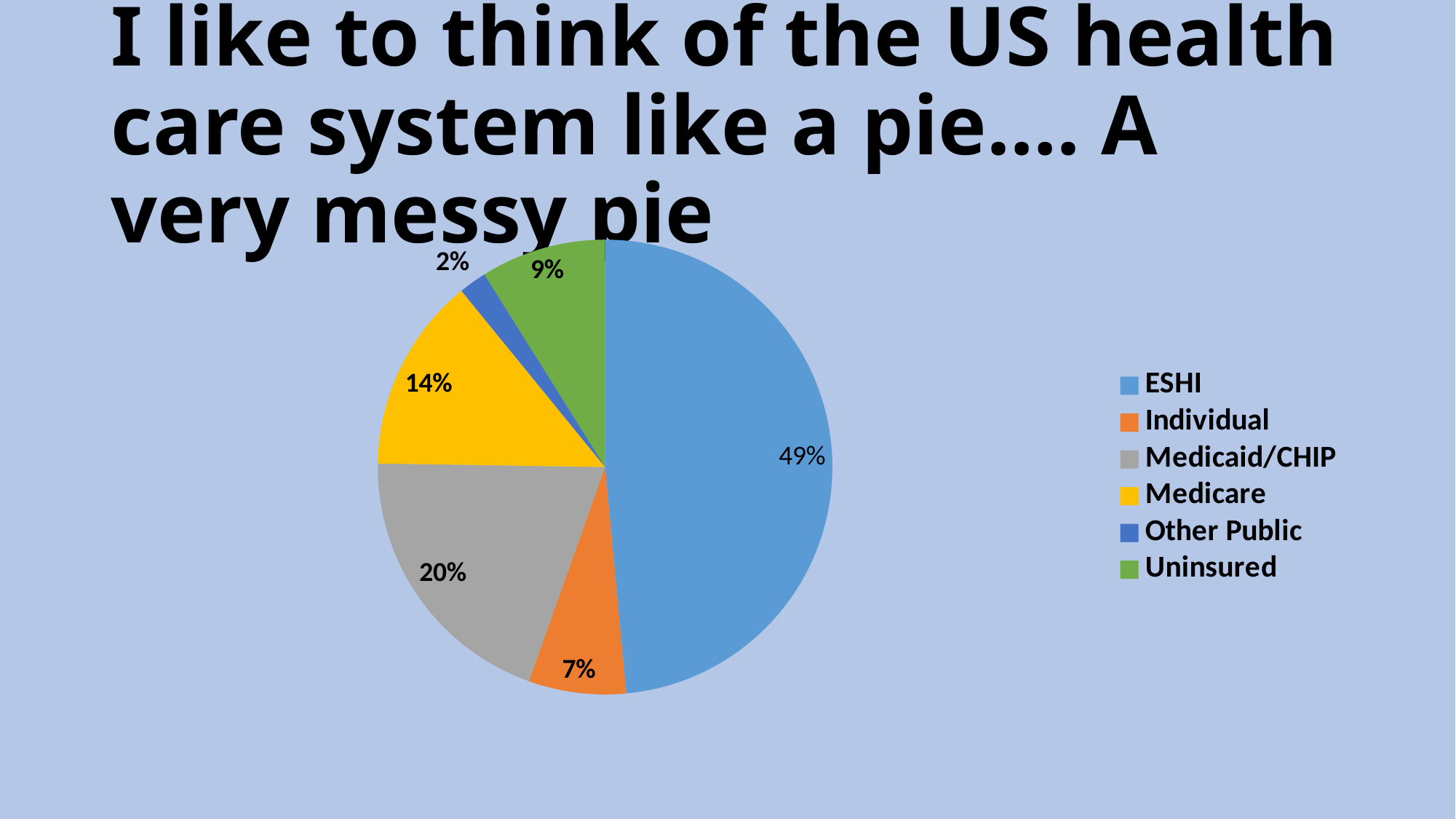
What percentage is shown for Other Public? 2% Which category has the smallest slice of the pie? Other Public What type of chart is shown on the slide? Pie chart What percentage is shown for Medicaid/CHIP? 20% What percentage is shown for Medicare? 14% What is the difference in percentage points between Medicaid/CHIP and Medicare? 6 Which is larger, the Uninsured slice or the Individual slice? Uninsured What percentage is shown for Individual? 7% Which category has the largest slice of the pie? ESHI How many categories does the legend list? 6 What percentage is shown for Uninsured? 9% What share of the pie does ESHI represent? 49%